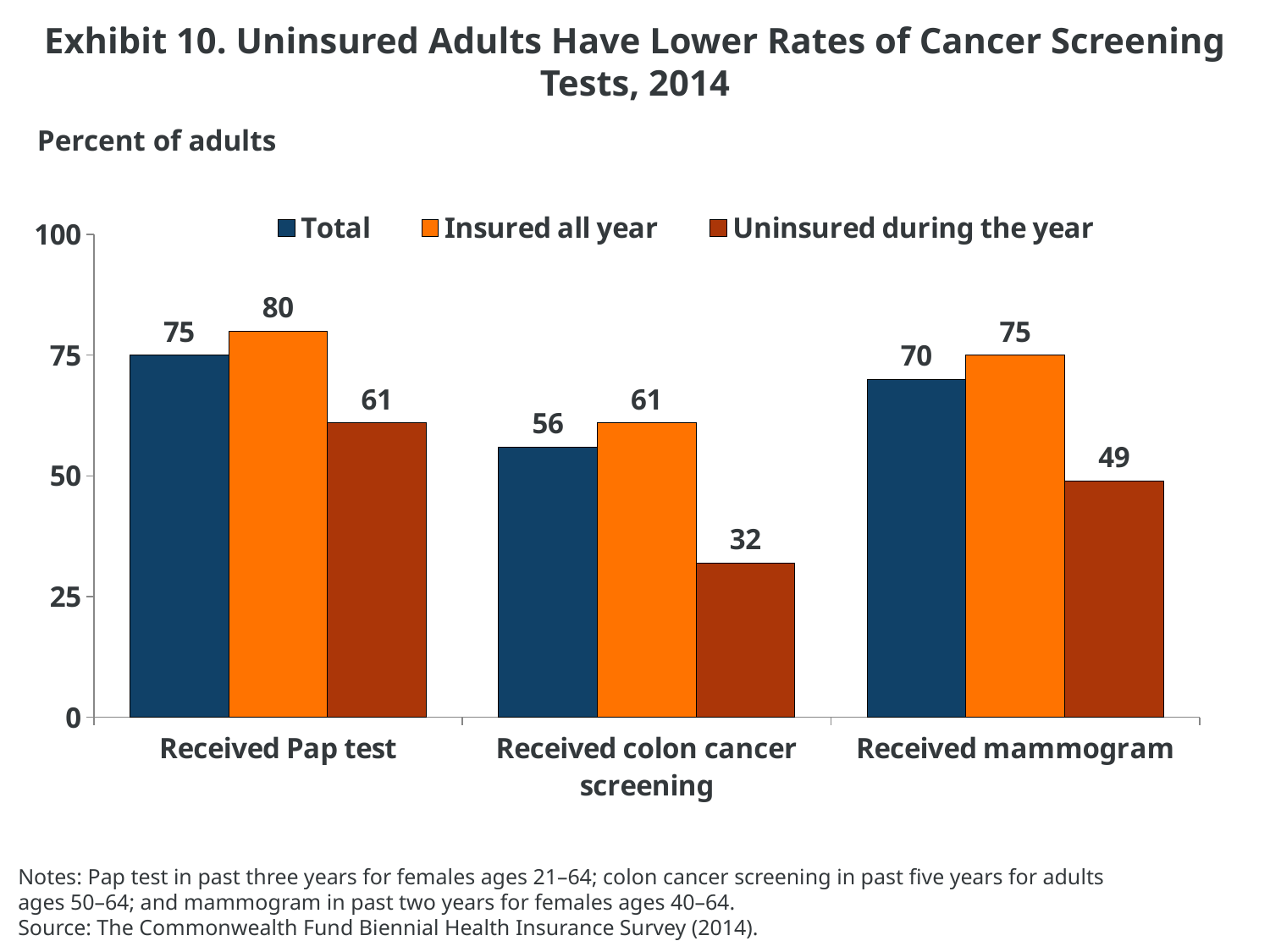
Which category has the highest value for Insured all year? Received Pap test What kind of chart is shown on the slide? Bar chart How many series does the legend list? 3 What is the value for Uninsured during the year for Received colon cancer screening? 32 Which category has the lowest value for Uninsured during the year? Received colon cancer screening How many categories are shown on the x axis? 3 What is the title of the chart? Exhibit 10. Uninsured Adults Have Lower Rates of Cancer Screening Tests, 2014 What is the difference between Insured all year and Uninsured during the year for Received mammogram? 26 What is the difference between Insured all year and Uninsured during the year for Received colon cancer screening? 29 Which is larger for Received Pap test: the Total value or the Uninsured during the year value? Total What is the value for Insured all year for Received Pap test? 80 What is the Total value for Received mammogram? 70